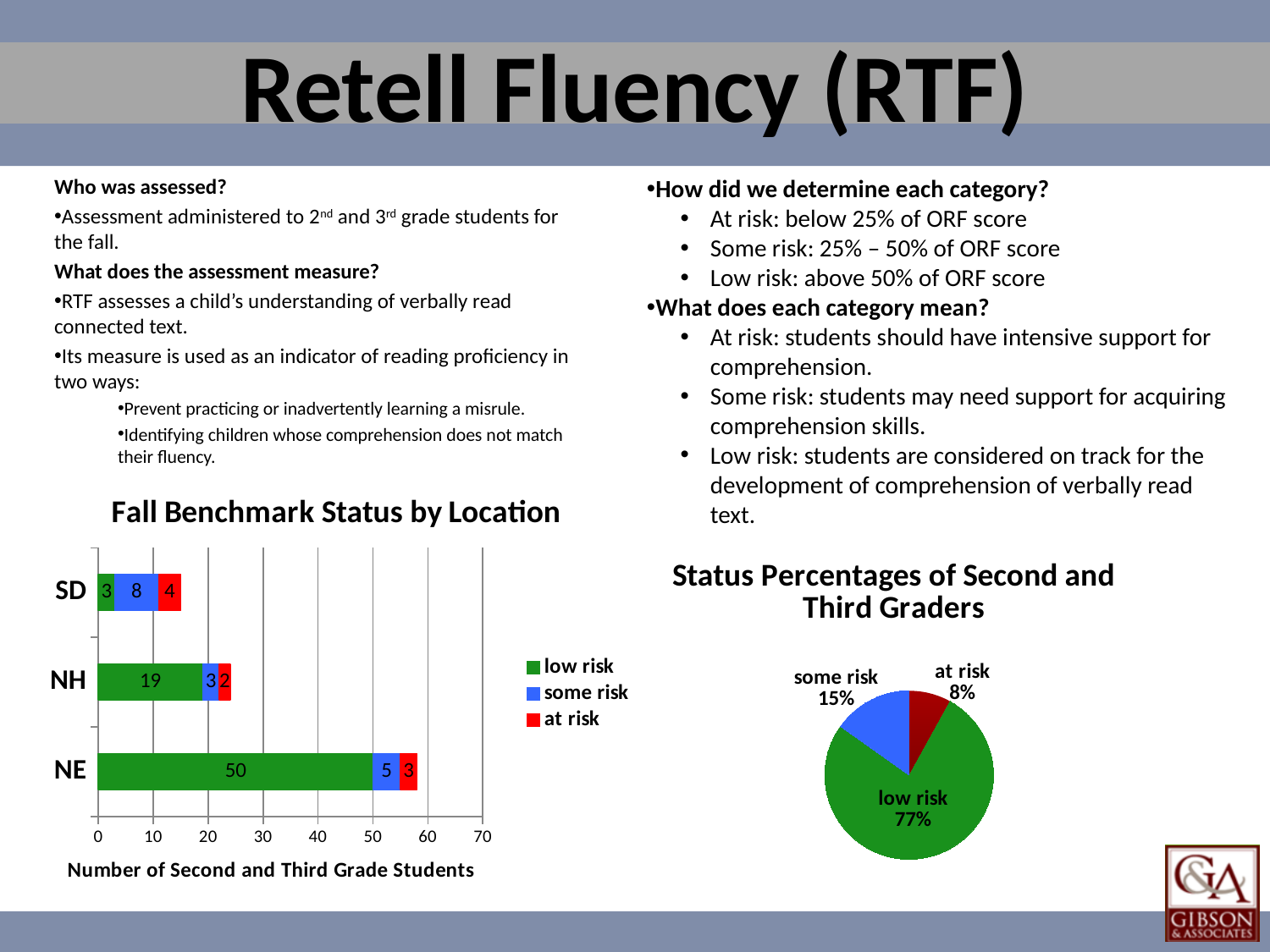
In the Fall Benchmark Status by Location chart, how many SD students are at some risk? 8 In the Fall Benchmark Status by Location chart, how many NE students are at low risk? 50 In the Status Percentages of Second and Third Graders pie chart, which category has the smallest share? at risk In the Fall Benchmark Status by Location chart, which location has the most low-risk students? NE In the Status Percentages of Second and Third Graders pie chart, what is the difference between the some risk and at risk shares? 7% In the Status Percentages of Second and Third Graders pie chart, what share is low risk? 77% In the Fall Benchmark Status by Location chart, how many NH students are at risk? 2 In the Fall Benchmark Status by Location chart, what is the total number of students for NH? 24 In the Fall Benchmark Status by Location chart, what is the difference between the low-risk counts for NE and NH? 31 In the Fall Benchmark Status by Location chart, which location has the fewest low-risk students? SD In the Fall Benchmark Status by Location chart, how many series does the legend list? 3 What kind of chart is Fall Benchmark Status by Location? Bar chart